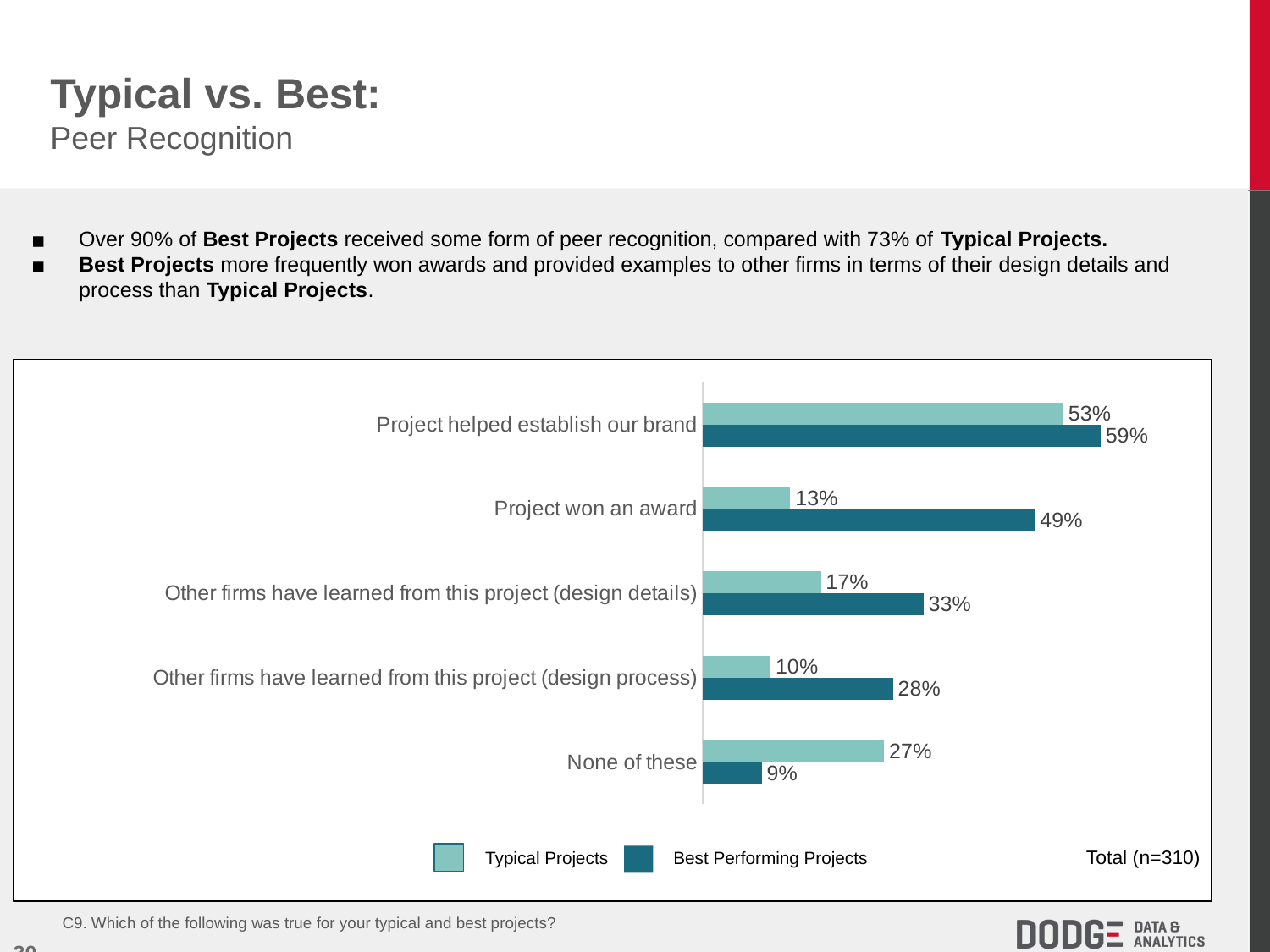
How many categories are shown on the chart? 5 What is the difference between Typical Projects and Best Performing Projects for "Project helped establish our brand"? 6% Which category has the lowest value for Typical Projects? Other firms have learned from this project (design process) For "None of these", which series has the larger value, Typical Projects or Best Performing Projects? Typical Projects How many series does the legend list? 2 Which category has the highest value for Best Performing Projects? Project helped establish our brand What kind of chart is shown on the slide? Bar chart What is the value for Typical Projects for "Project won an award"? 13% What sample size is shown next to the legend? Total (n=310) What is the difference between Best Performing Projects and Typical Projects for "Project won an award"? 36% What is the value for Best Performing Projects for "Other firms have learned from this project (design process)"? 28% What is the value for Best Performing Projects for "None of these"? 9%